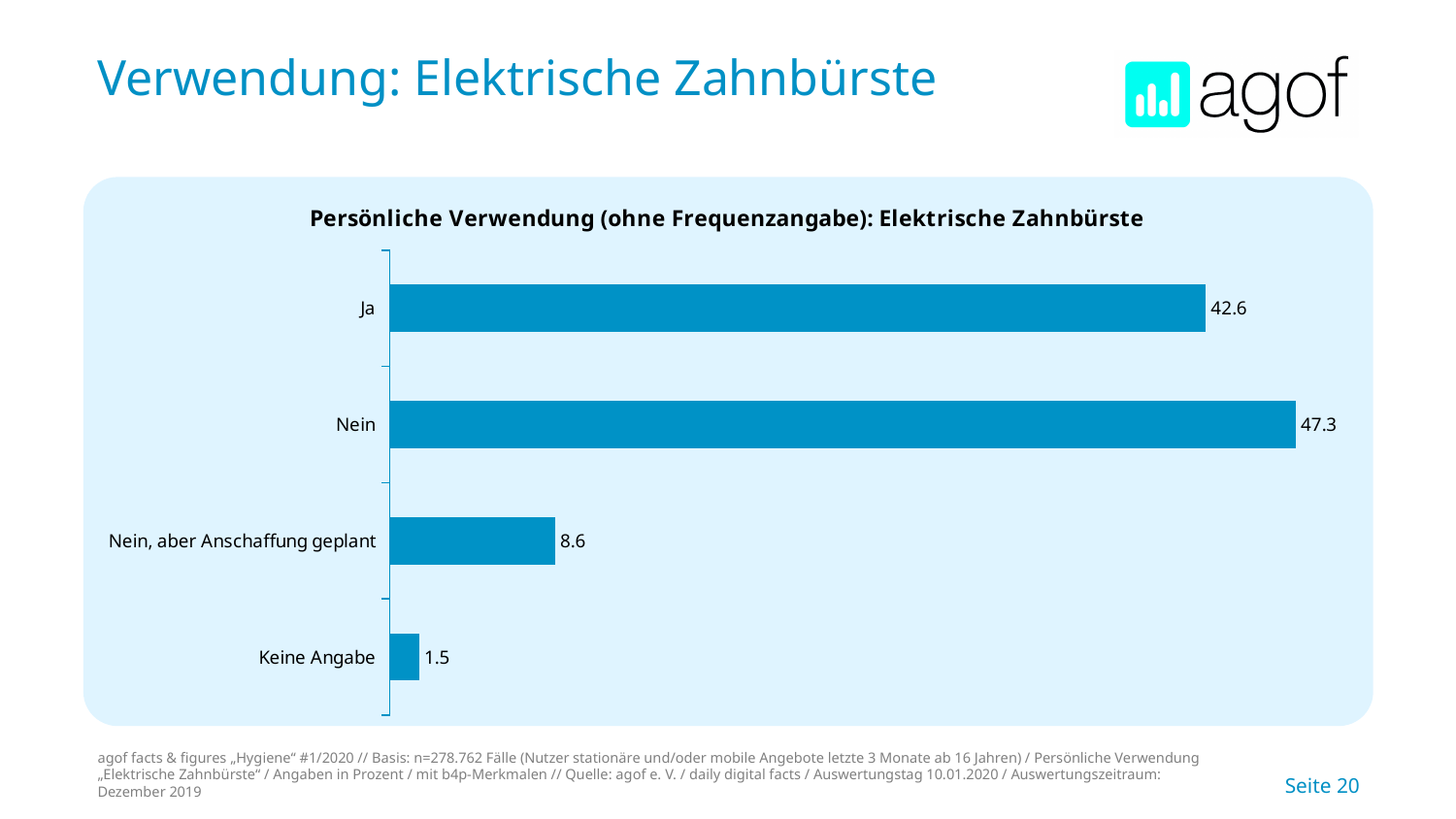
What is the value for "Ja"? 42.6 Which is larger, the value for "Ja" or the value for "Nein, aber Anschaffung geplant"? Ja Which category has the highest value? Nein What is the difference between the values for "Nein" and "Ja"? 4.7 What kind of chart is shown on the slide? Bar chart What is the value for "Nein"? 47.3 What is the difference between the values for "Nein, aber Anschaffung geplant" and "Keine Angabe"? 7.1 What is the value for "Nein, aber Anschaffung geplant"? 8.6 What is the title of the chart? Persönliche Verwendung (ohne Frequenzangabe): Elektrische Zahnbürste What is the value for "Keine Angabe"? 1.5 Which category has the lowest value? Keine Angabe How many categories are shown in the chart? 4